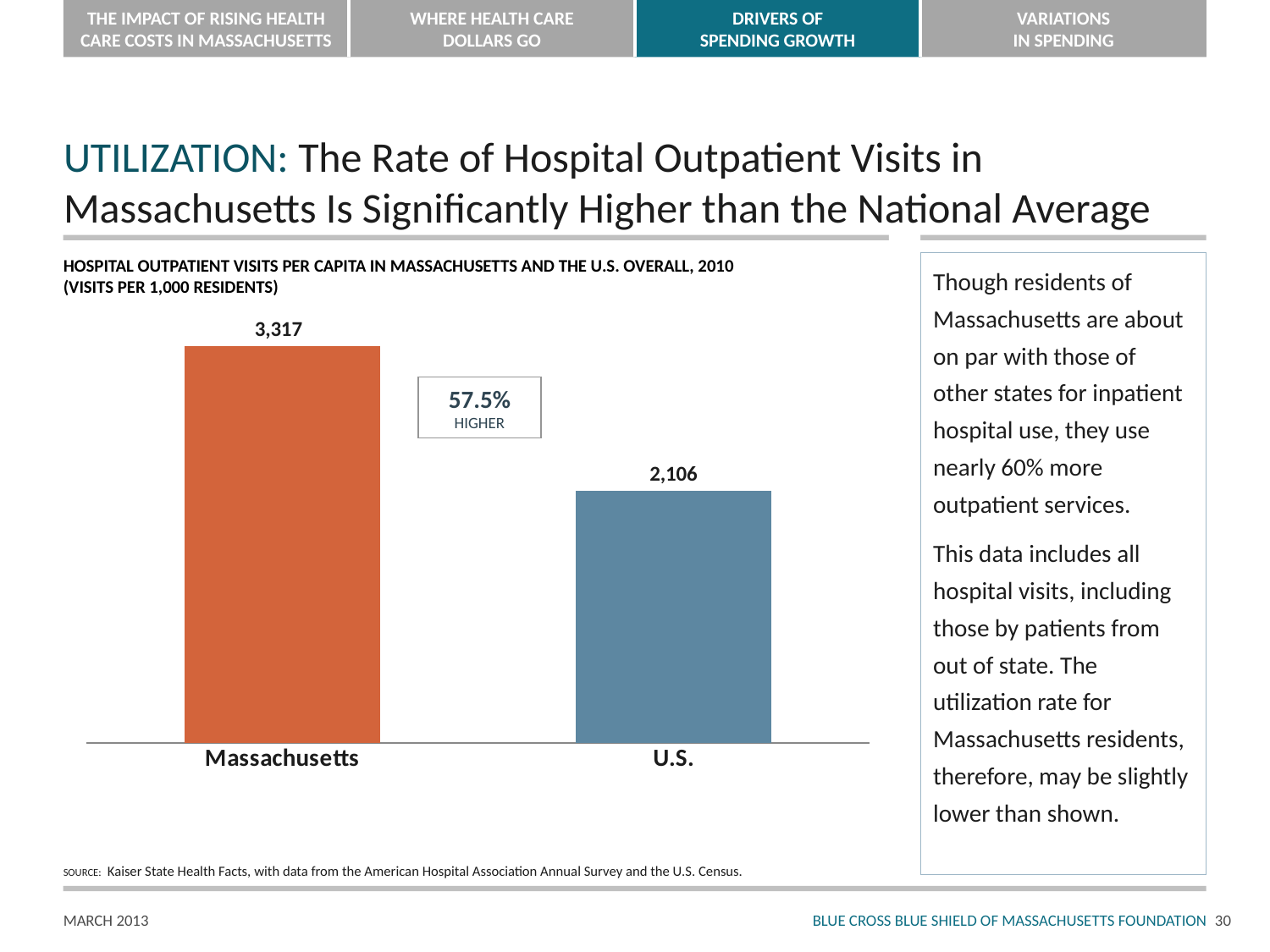
How many categories are shown in the chart? 2 What is the value for U.S.? 2,106 By what percentage is the Massachusetts value higher than the U.S. value, according to the label on the chart? 57.5% Which category has the lowest value? U.S. Which category has the highest value? Massachusetts What is the title of the chart? Hospital Outpatient Visits per Capita in Massachusetts and the U.S. Overall, 2010 (Visits per 1,000 Residents) Which is larger, the value for Massachusetts or the value for U.S.? Massachusetts What kind of chart is shown on the slide? Bar chart What is the value for Massachusetts? 3,317 What is the difference between the Massachusetts and U.S. values? 1,211